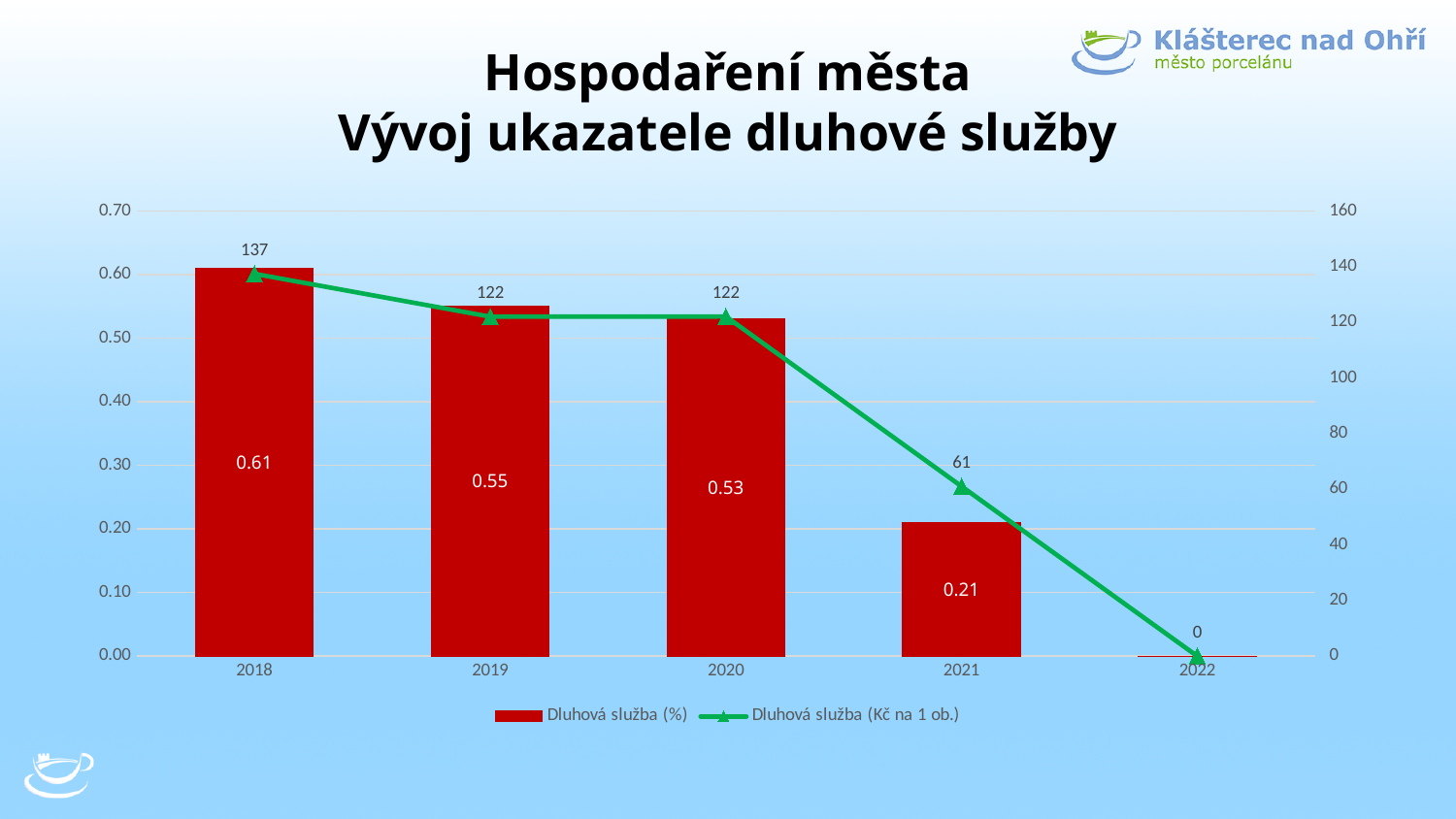
What is the value of Dluhová služba (Kč na 1 ob.) for 2021? 61 Which is larger, the Dluhová služba (%) value for 2019 or for 2020? 2019 What is the overall trend of Dluhová služba (Kč na 1 ob.) from 2018 to 2022? Falling Which year has the highest value of Dluhová služba (Kč na 1 ob.)? 2018 How many years are shown on the x axis? 5 What is the difference between the Dluhová služba (%) values for 2018 and 2021? 0.40 What is the value of Dluhová služba (%) for 2020? 0.53 What is the value of Dluhová služba (Kč na 1 ob.) for 2022? 0 What is the value of Dluhová služba (%) for 2018? 0.61 Which year has the lowest value of Dluhová služba (%)? 2022 What is the difference between the Dluhová služba (Kč na 1 ob.) values for 2018 and 2019? 15 How many series does the legend list? 2